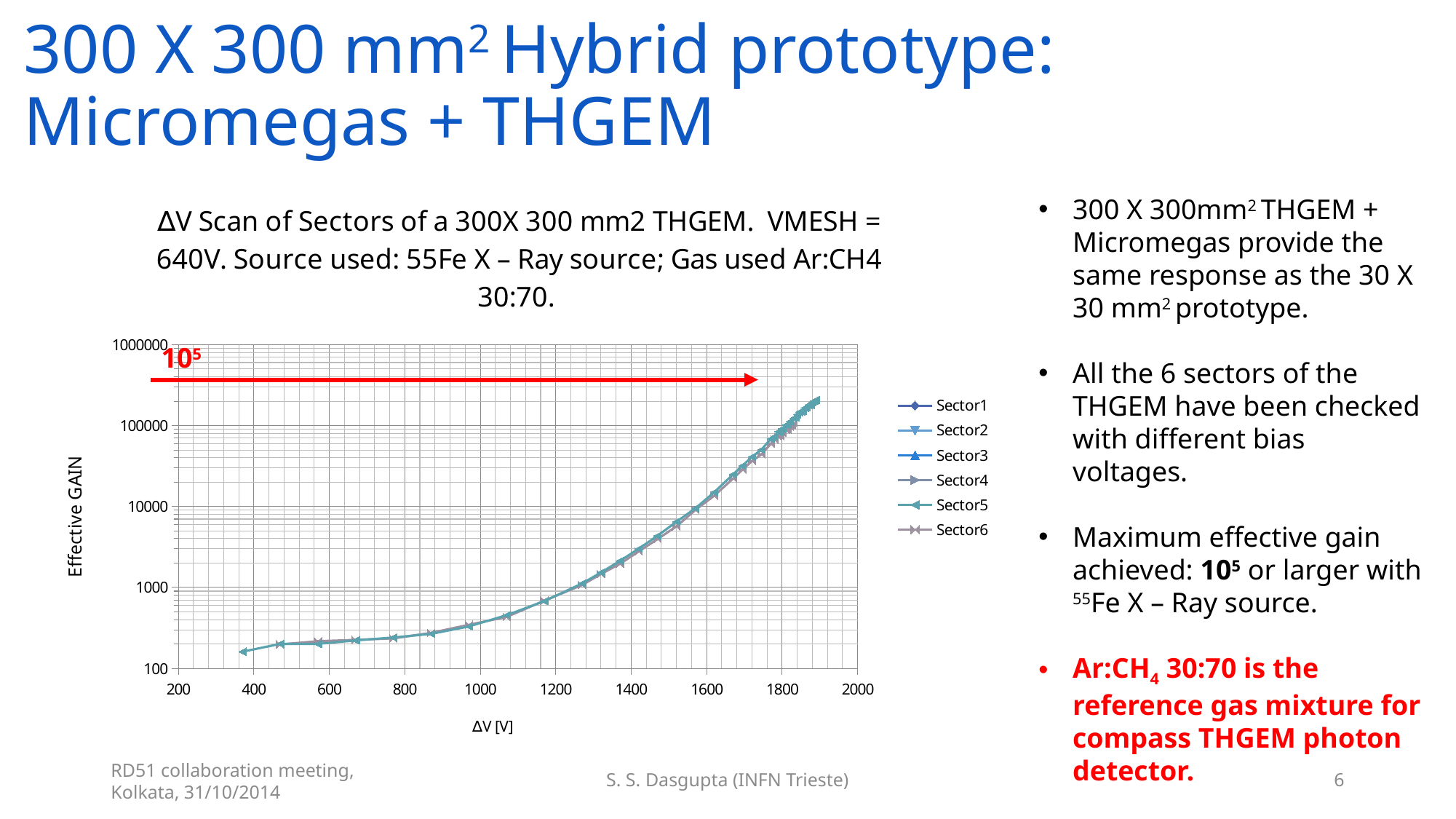
Is the effective gain at ΔV = 1400 V greater or less than 10000? less What is the label of the chart's vertical axis? Effective GAIN Is the highest effective gain reached by the sectors greater or less than 1000000? less What are the names of the series listed in the chart legend? Sector1, Sector2, Sector3, Sector4, Sector5, Sector6 Is the effective gain at ΔV = 1400 V greater or less than 1000? greater What is the maximum value shown on the chart's x axis? 2000 What kind of chart is shown on the slide? line chart How many series does the chart legend list? 6 Does the effective gain rise or fall as ΔV increases along the x axis? rise